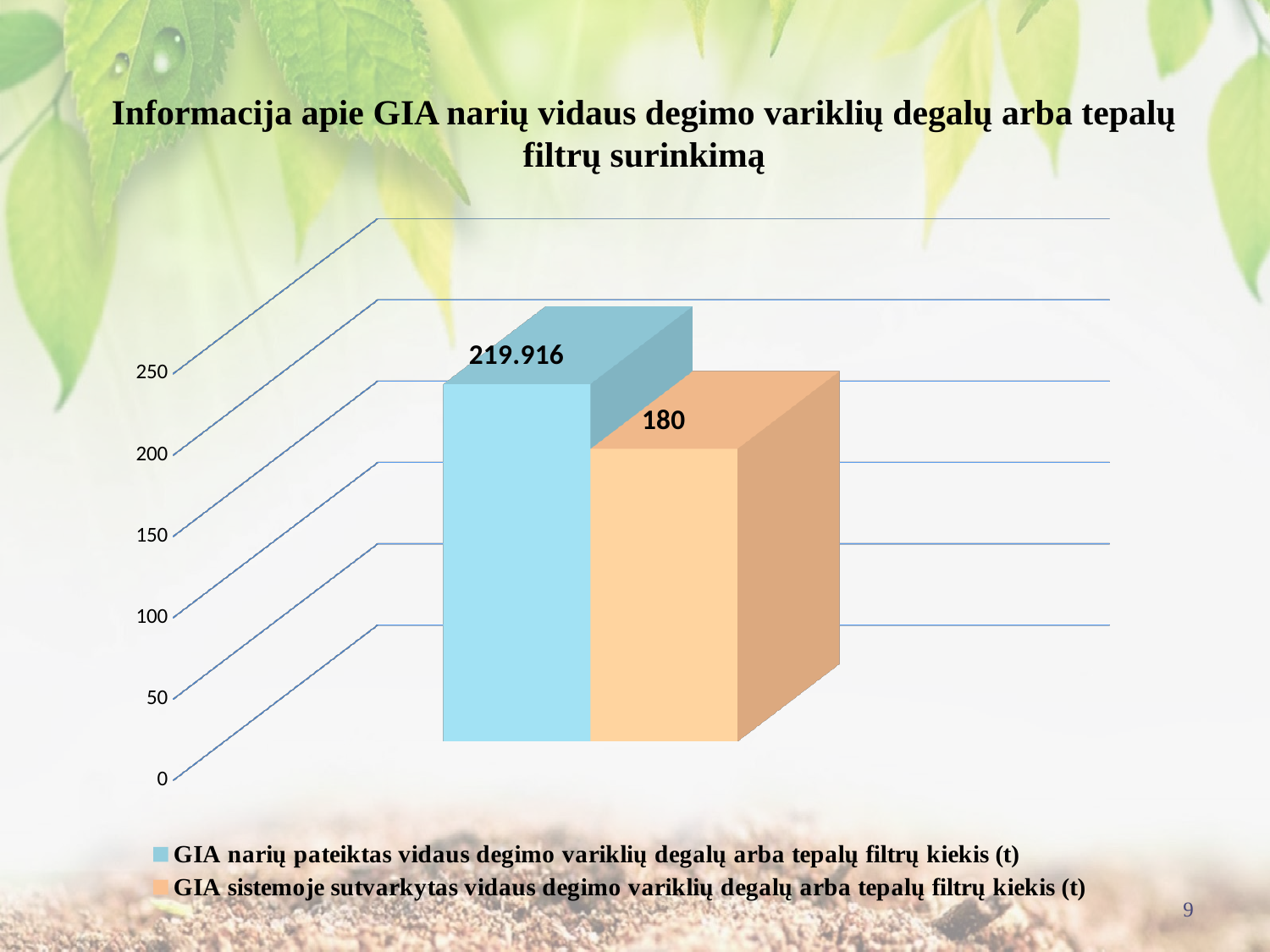
What value is shown for the series 'GIA narių pateiktas vidaus degimo variklių degalų arba tepalų filtrų kiekis (t)'? 219.916 What kind of chart is shown on the slide? bar chart What colour is the bar for 'GIA sistemoje sutvarkytas vidaus degimo variklių degalų arba tepalų filtrų kiekis (t)'? orange What is the difference between the value for 'GIA narių pateiktas' filters (219.916) and 'GIA sistemoje sutvarkytas' filters (180)? 39.916 Is the value for 'GIA narių pateiktas vidaus degimo variklių degalų arba tepalų filtrų kiekis (t)' greater or less than 200? greater What value is shown for the series 'GIA sistemoje sutvarkytas vidaus degimo variklių degalų arba tepalų filtrų kiekis (t)'? 180 Which series has the lower value? GIA sistemoje sutvarkytas vidaus degimo variklių degalų arba tepalų filtrų kiekis (t) How many bars are plotted on the chart? 2 How many series does the legend list? 2 Is the value for 'GIA sistemoje sutvarkytas vidaus degimo variklių degalų arba tepalų filtrų kiekis (t)' greater or less than 200? less Is the value for 'GIA narių pateiktas vidaus degimo variklių degalų arba tepalų filtrų kiekis (t)' larger or smaller than the value for 'GIA sistemoje sutvarkytas vidaus degimo variklių degalų arba tepalų filtrų kiekis (t)'? larger Which series has the higher value? GIA narių pateiktas vidaus degimo variklių degalų arba tepalų filtrų kiekis (t)